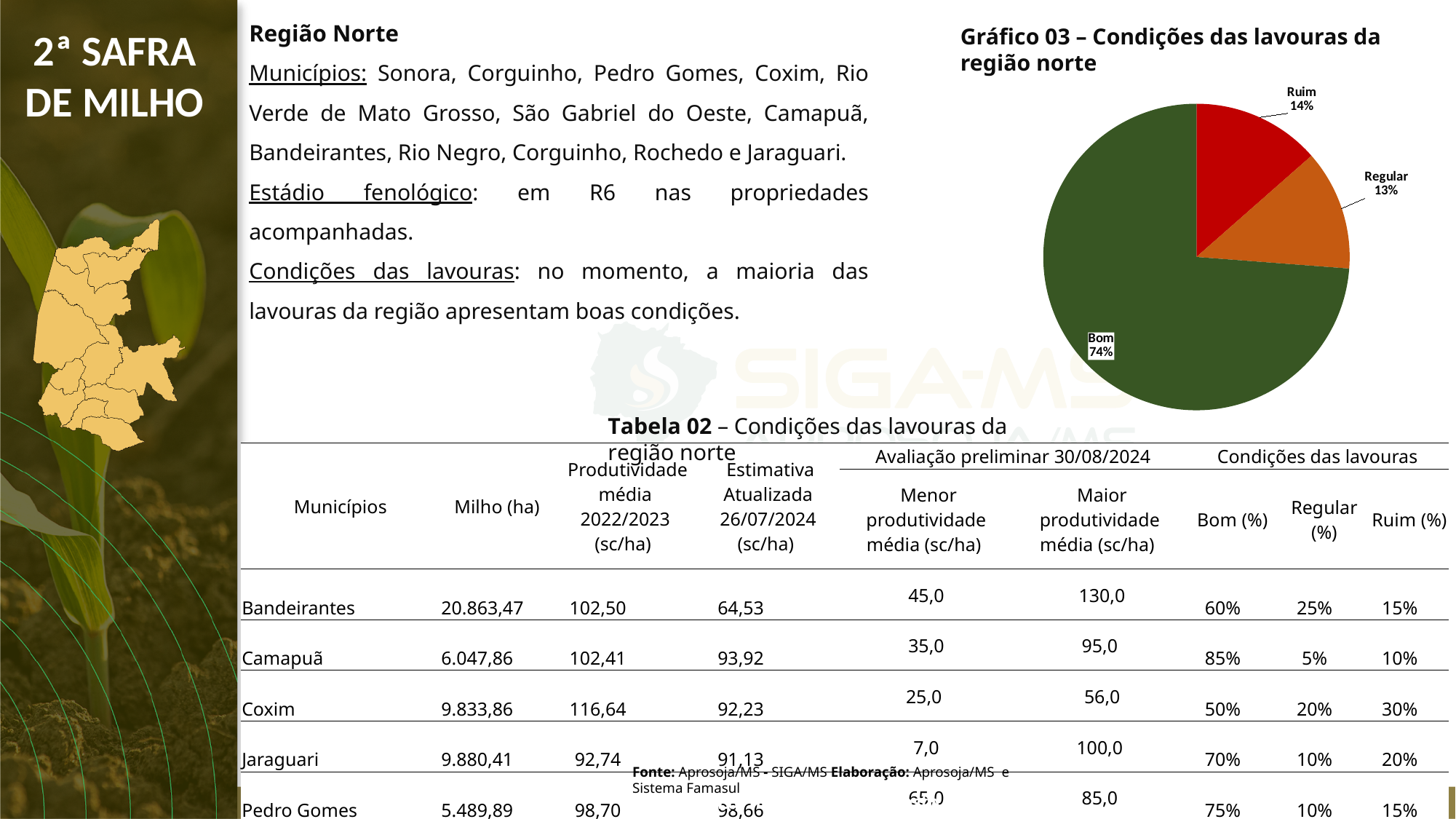
What colour is the Bom slice in the pie chart? Dark green What kind of chart is shown on the slide? Pie chart What is the value shown for the Regular slice in the pie chart? 13% What share of the pie chart is labelled Bom? 74% Which category has the largest slice in the pie chart? Bom What is the title of the chart on the slide? Gráfico 03 – Condições das lavouras da região norte What is the difference in percentage points between the Ruim and Regular slices? 1 Which category has the smallest slice in the pie chart? Regular Which slice is larger, Bom or Ruim? Bom How many slices does the pie chart have? 3 What is the difference in percentage points between the Bom and Ruim slices? 60 What is the value shown for the Ruim slice in the pie chart? 14%